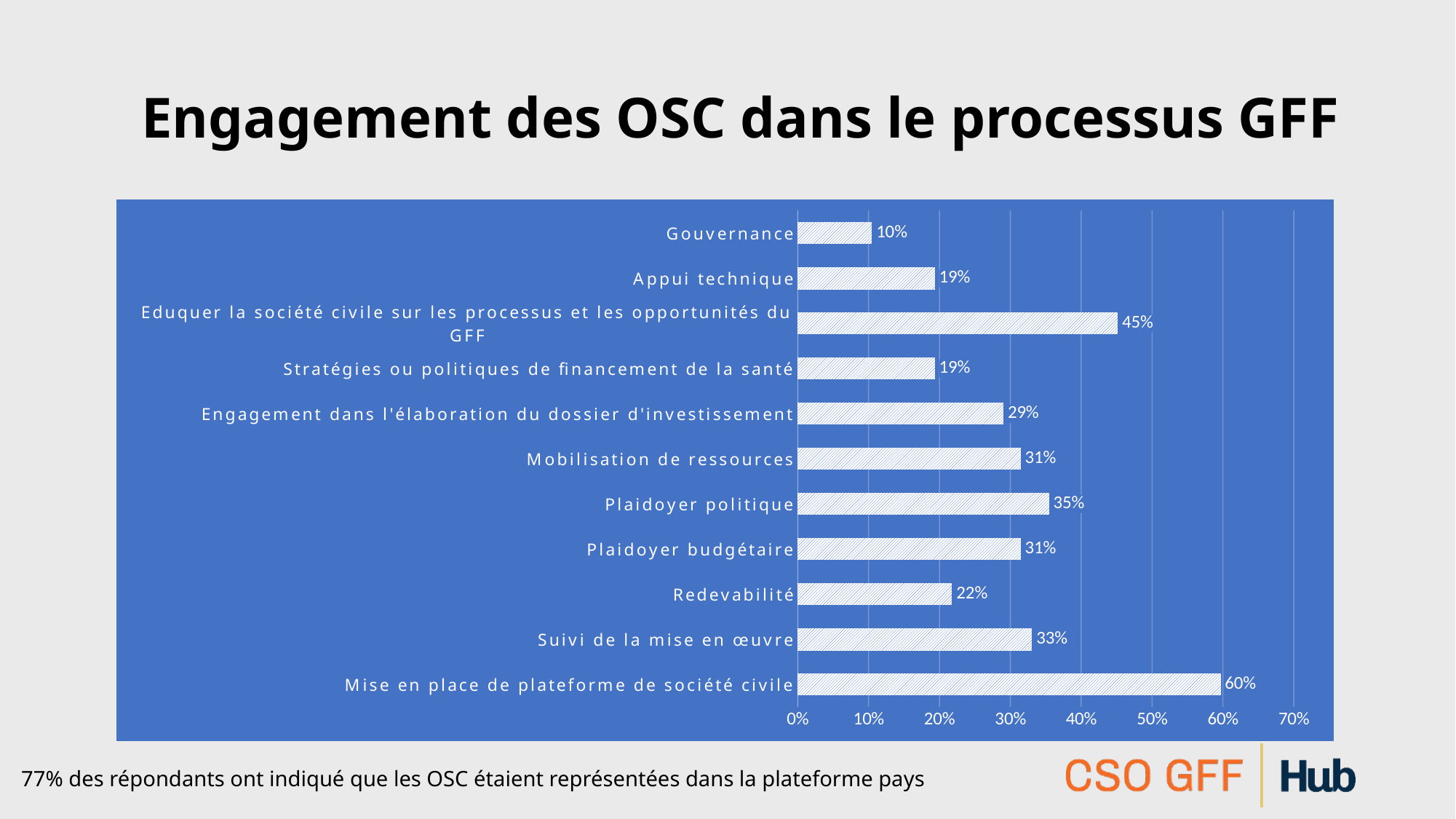
What is the value for Plaidoyer politique? 35% What is the value for Mise en place de plateforme de société civile? 60% What is the value for Redevabilité? 22% Is the value for Engagement dans l'élaboration du dossier d'investissement greater or less than 20%? greater Which category has the highest value? Mise en place de plateforme de société civile How many categories are shown in the chart? 11 What kind of chart is shown on the slide? bar chart Which is larger, the value for Suivi de la mise en œuvre or the value for Redevabilité? Suivi de la mise en œuvre What is the difference between the values for Mise en place de plateforme de société civile and Eduquer la société civile sur les processus et les opportunités du GFF? 15% What is the value for Gouvernance? 10% Which category has the lowest value? Gouvernance What is the title of the slide? Engagement des OSC dans le processus GFF